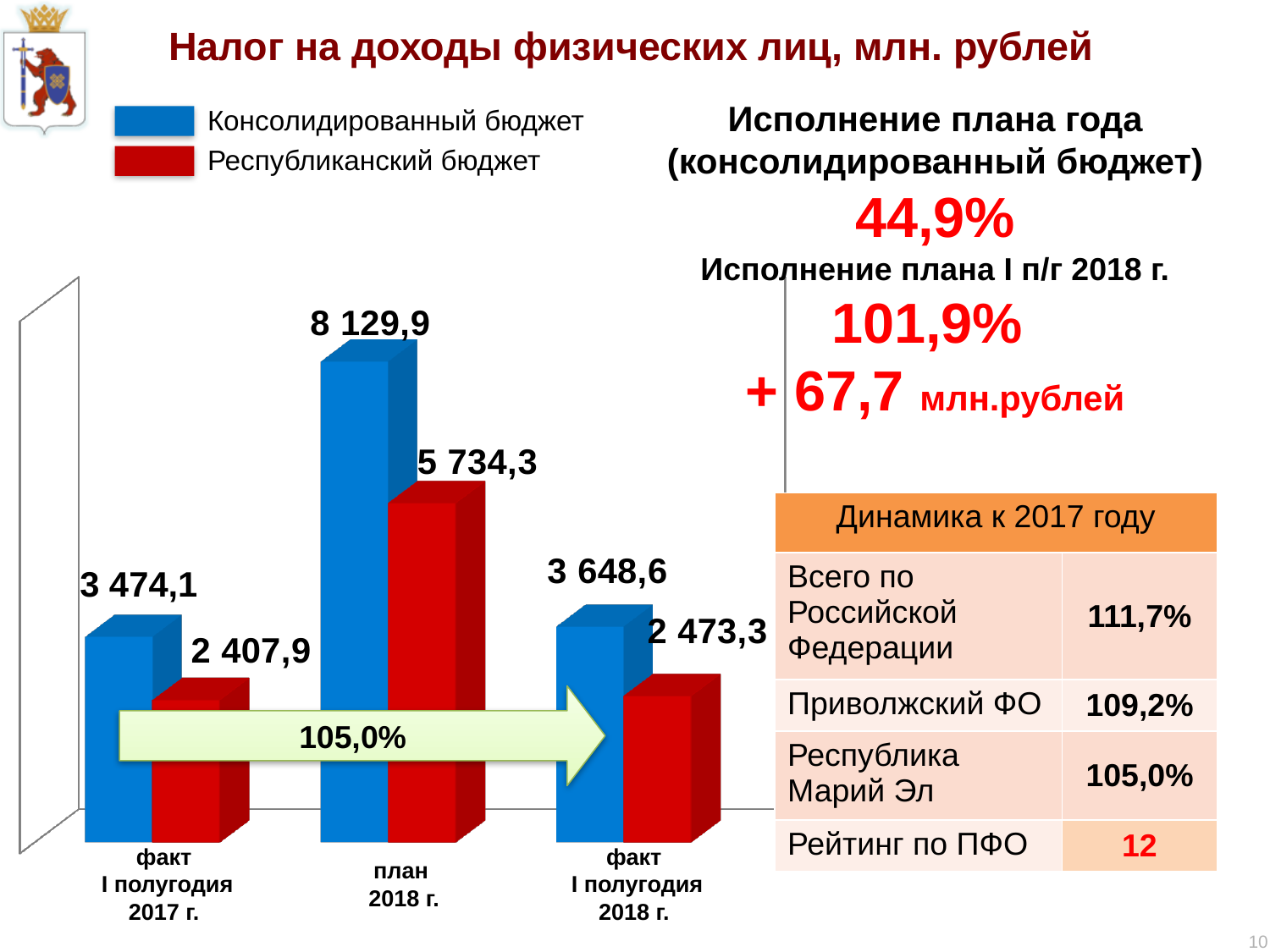
What is the difference between the Консолидированный бюджет and Республиканский бюджет values for план 2018 г.? 2 395,6 How many series does the legend list? 2 What is the difference between the Консолидированный бюджет values for факт I полугодия 2018 г. and факт I полугодия 2017 г.? 174,5 Which category has the lowest value for the Республиканский бюджет series? факт I полугодия 2017 г. What is the value of the Консолидированный бюджет series for план 2018 г.? 8 129,9 Which category has the highest value for the Консолидированный бюджет series? план 2018 г. What is the value of the Республиканский бюджет series for факт I полугодия 2017 г.? 2 407,9 What is the value of the Консолидированный бюджет series for факт I полугодия 2018 г.? 3 648,6 How many categories are shown on the x axis of the chart? 3 What kind of chart is shown on the slide? bar chart Which is larger: the Республиканский бюджет value for факт I полугодия 2018 г. or for факт I полугодия 2017 г.? факт I полугодия 2018 г. What is the value of the Республиканский бюджет series for факт I полугодия 2018 г.? 2 473,3